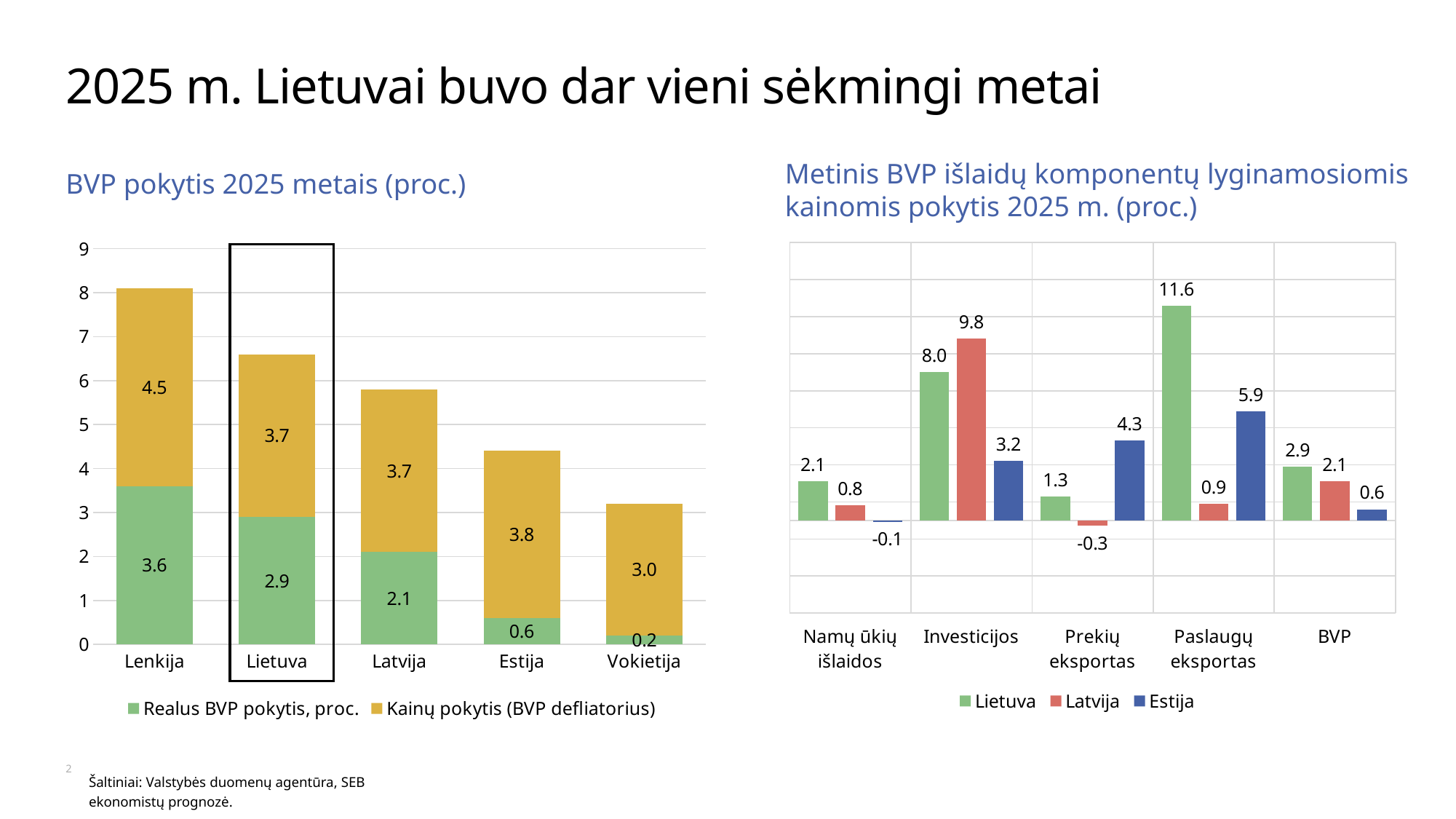
What kind of chart is 'Metinis BVP išlaidų komponentų lyginamosiomis kainomis pokytis 2025 m. (proc.)'? Bar chart In the chart 'Metinis BVP išlaidų komponentų lyginamosiomis kainomis pokytis 2025 m. (proc.)', what is the value for Latvija in Investicijos? 9.8 In the chart 'BVP pokytis 2025 metais (proc.)', what is the value of 'Realus BVP pokytis, proc.' for Lenkija? 3.6 In the chart 'BVP pokytis 2025 metais (proc.)', what is the value of 'Kainų pokytis (BVP defliatorius)' for Estija? 3.8 In the chart 'BVP pokytis 2025 metais (proc.)', is the total stacked bar for Lenkija greater or less than 8? greater In the chart 'Metinis BVP išlaidų komponentų lyginamosiomis kainomis pokytis 2025 m. (proc.)', which category has the highest value for Lietuva? Paslaugų eksportas In the chart 'BVP pokytis 2025 metais (proc.)', how many countries are shown on the x axis? 5 In the chart 'Metinis BVP išlaidų komponentų lyginamosiomis kainomis pokytis 2025 m. (proc.)', which is larger for Prekių eksportas: Lietuva or Estija? Estija In the chart 'BVP pokytis 2025 metais (proc.)', what is the difference between the 'Realus BVP pokytis, proc.' values for Lenkija and Latvija? 1.5 In the chart 'Metinis BVP išlaidų komponentų lyginamosiomis kainomis pokytis 2025 m. (proc.)', how many series does the legend list? 3 In the chart 'BVP pokytis 2025 metais (proc.)', which country has the lowest 'Realus BVP pokytis, proc.' value? Vokietija In the chart 'BVP pokytis 2025 metais (proc.)', what is the total of the stacked bar for Lietuva? 6.6